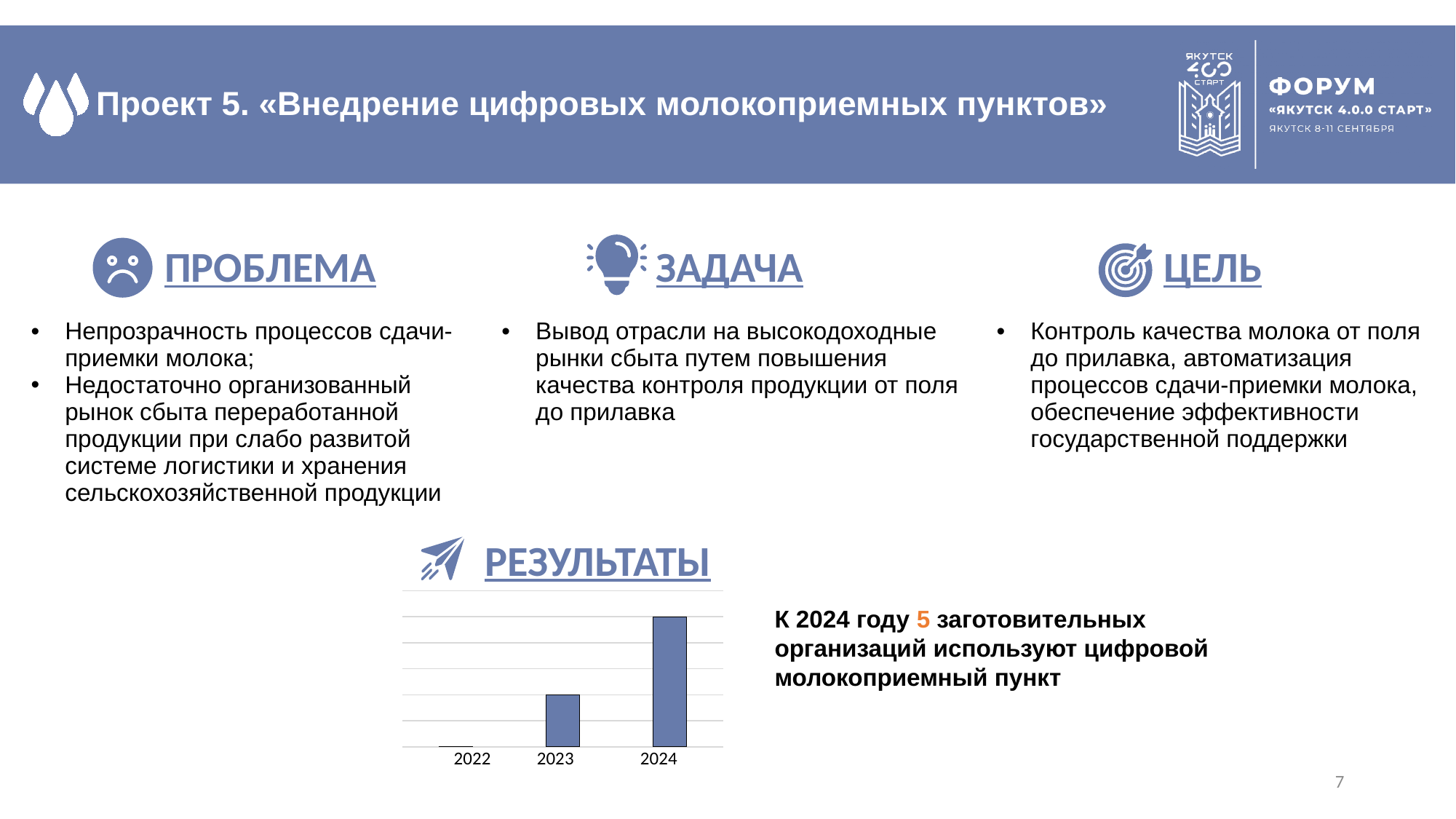
Do the bar values rise or fall from 2022 to 2024? rise Which year has the highest bar in the chart? 2024 Which bar is taller, 2023 or 2024? 2024 Which bar is taller, 2022 or 2023? 2023 What kind of chart is shown under the heading «РЕЗУЛЬТАТЫ»? bar chart What is the first category label on the x axis of the bar chart? 2022 How many categories (years) are shown on the x axis of the bar chart? 3 Which year has the lowest bar in the chart? 2022 What is the last category label on the x axis of the bar chart? 2024